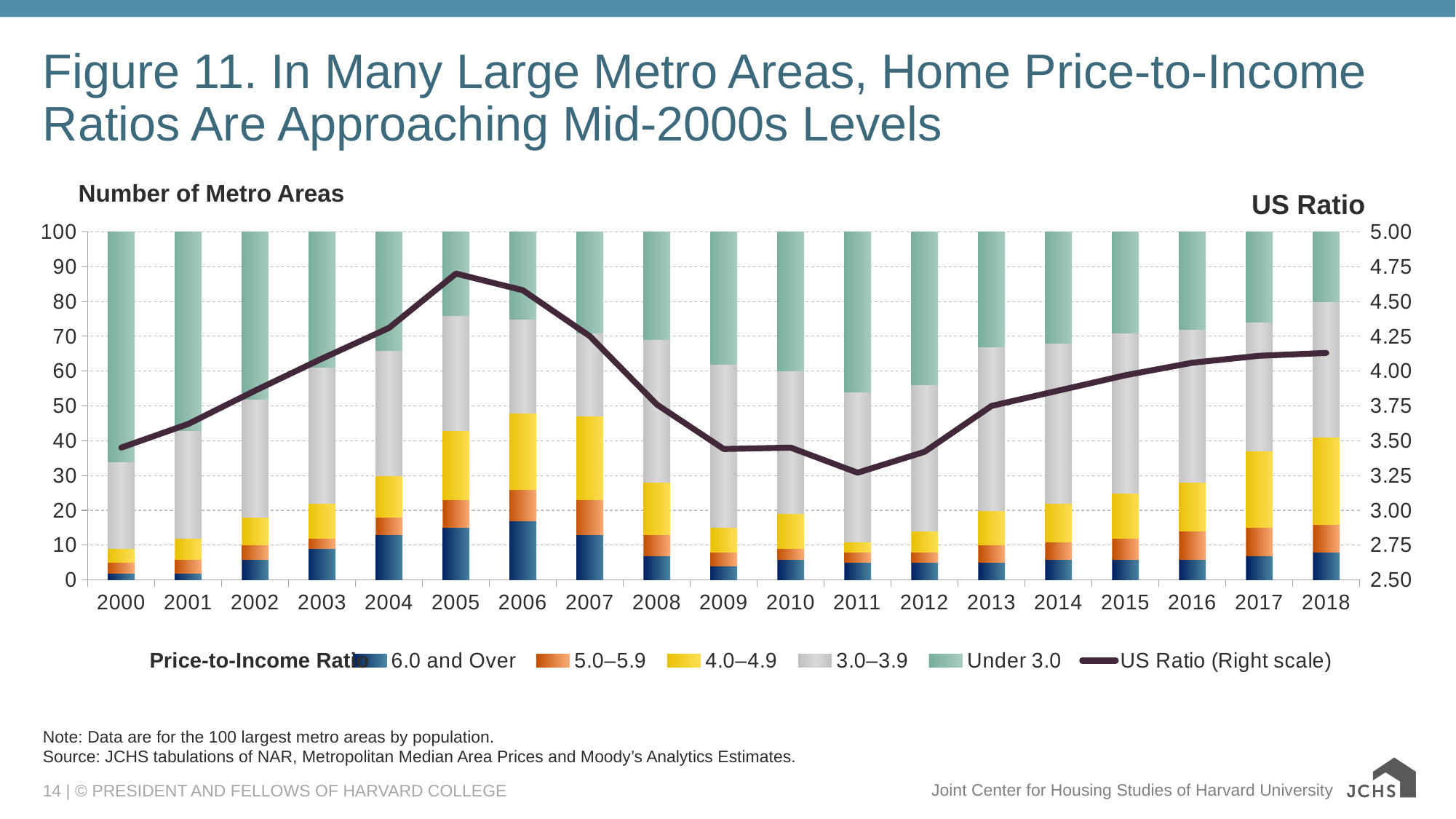
In which year does the US Ratio line reach its lowest value? 2011 In which year does the US Ratio line reach its highest value? 2005 Is the US Ratio in 2005 greater or less than 4.50? greater Which year has the larger '6.0 and Over' segment, 2006 or 2009? 2006 Does the US Ratio line rise or fall between 2005 and 2011? fall Is the US Ratio in 2011 greater or less than 3.50? less How many years are shown along the x axis? 19 Does the US Ratio line rise or fall between 2011 and 2018? rise What kind of chart is shown on the slide? Stacked bar chart with a line What is the title of the left vertical axis? Number of Metro Areas What is the total height of the stacked bar for 2010? 100 How many series does the legend list? 6